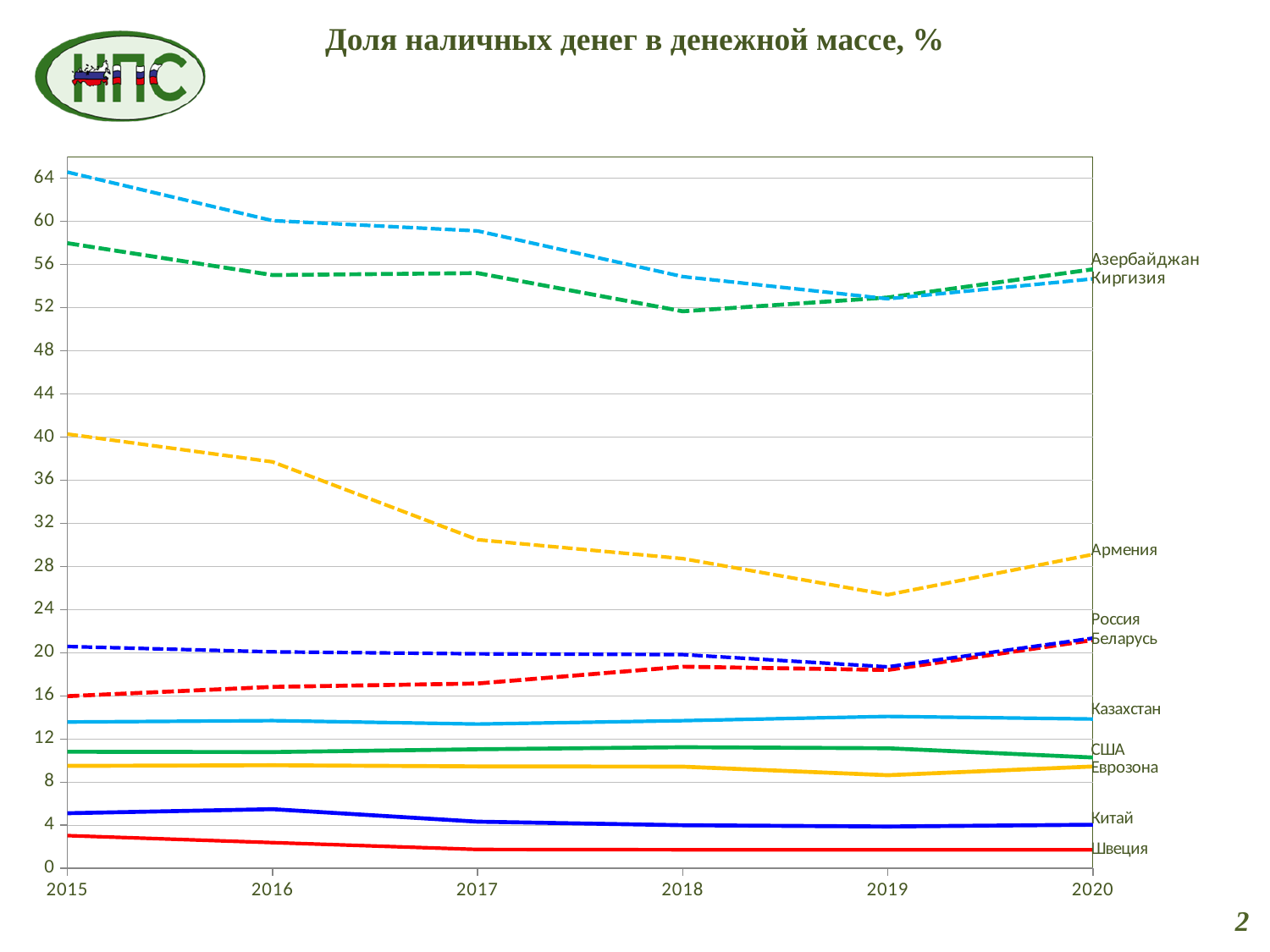
How many countries/regions (series) are plotted on the chart? 10 Is the value for Киргизия in 2015 greater or less than 60? greater In 2020, which is larger: the value for Армения or the value for Россия? Армения Which series has the lowest value in 2020? Швеция What is the title of the chart? Доля наличных денег в денежной массе, % What kind of chart is shown on the slide? line chart Does the value for Армения rise or fall from 2015 to 2019? fall Is the value for Армения in 2019 greater or less than 28? less Which series has the highest value in 2015? Киргизия Is the value for Беларусь in 2015 greater or less than 20? less How many years are plotted along the x axis? 6